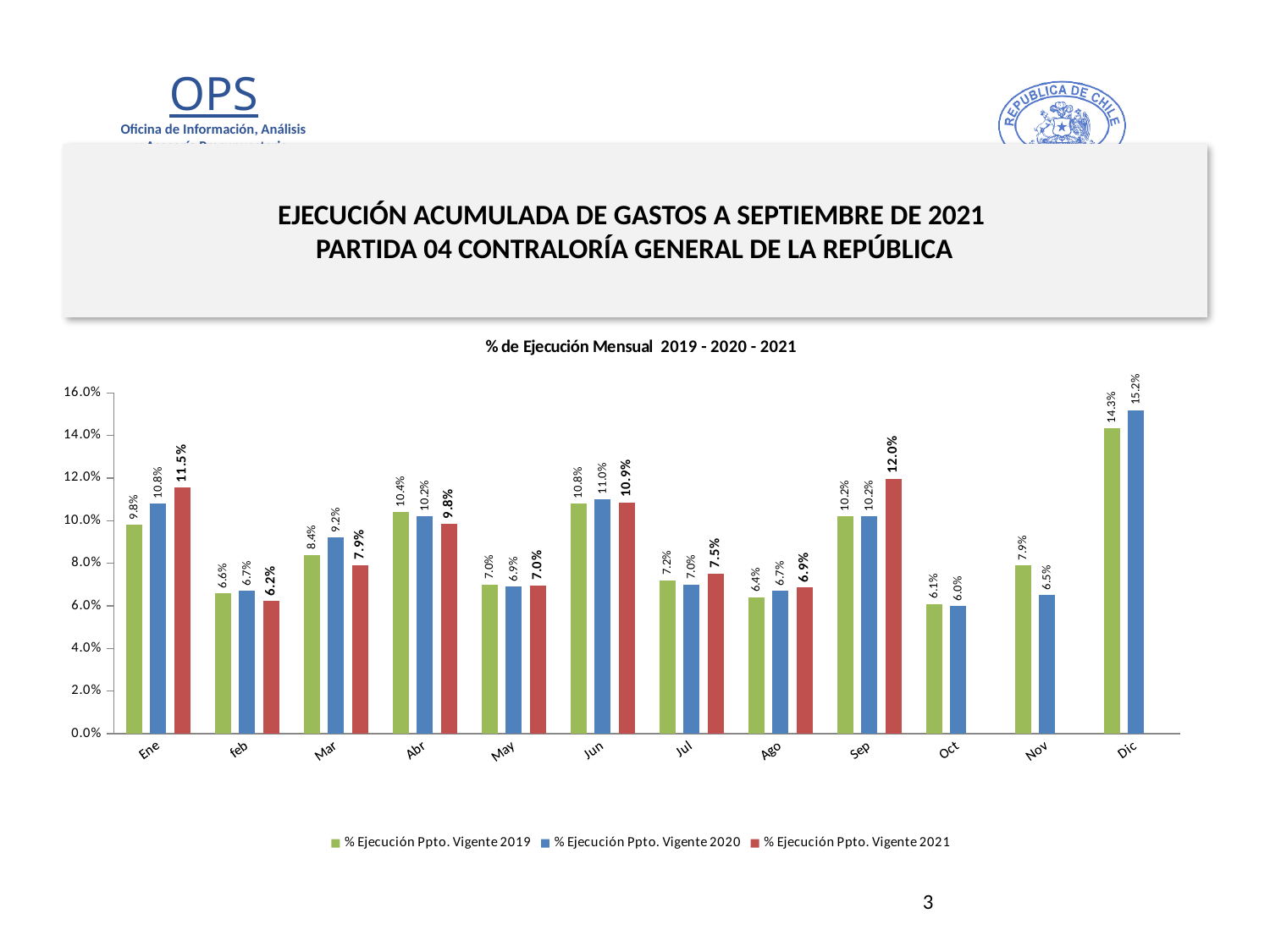
How many months are shown on the x axis? 12 Is the value for % Ejecución Ppto. Vigente 2019 in Dic greater or less than 12.0%? greater How many series does the legend list? 3 What is the value for % Ejecución Ppto. Vigente 2021 in Sep? 12.0% What kind of chart is shown on the slide? Bar chart What is the title of the chart? % de Ejecución Mensual 2019 - 2020 - 2021 What is the value for % Ejecución Ppto. Vigente 2020 in Dic? 15.2% What is the value for % Ejecución Ppto. Vigente 2019 in Abr? 10.4% What is the difference between the 2021 and 2019 values in Ene? 1.7% Which month has the highest value for % Ejecución Ppto. Vigente 2021? Sep Which is larger in Mar: the 2020 value or the 2021 value? 2020 value (9.2%) Which month has the lowest value for % Ejecución Ppto. Vigente 2020? Oct